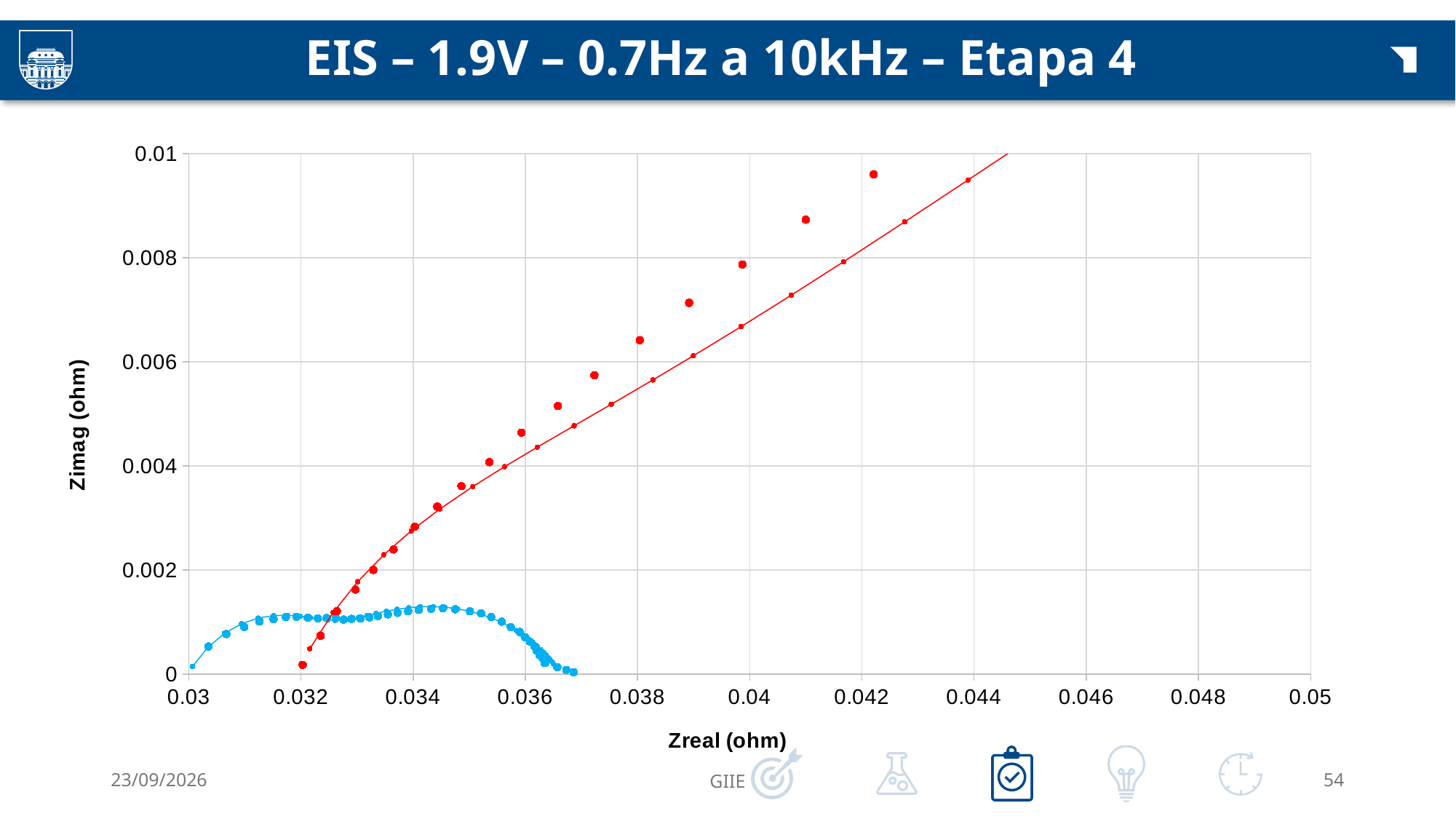
What is the highest value shown on the vertical axis? 0.01 What kind of chart is shown on the slide? scatter chart What is the label of the horizontal axis of the chart? Zreal (ohm) What is the title of the slide containing the chart? EIS – 1.9V – 0.7Hz a 10kHz – Etapa 4 Is the highest Zimag value reached by the blue series greater or less than 0.002? less Is the Zreal value of the rightmost red point greater or less than 0.04? greater Is the highest Zimag value reached by the red series greater or less than 0.008? greater Which series reaches higher Zimag values, the red one or the blue one? red Does the Zimag value of the red series rise or fall as Zreal increases? rise